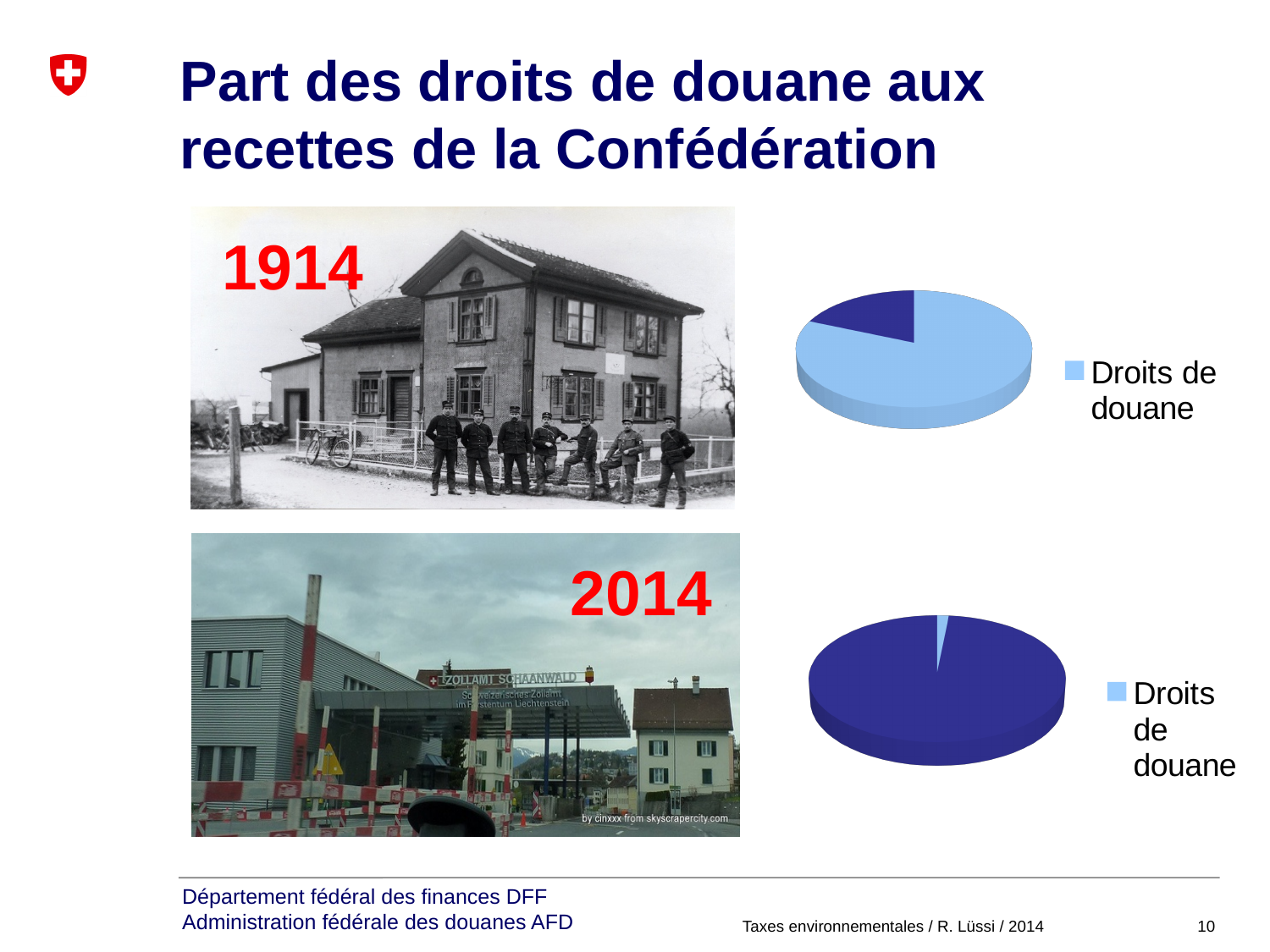
What kind of chart is shown next to the 1914 photo? Pie chart What kind of chart is shown next to the 2014 photo? Pie chart How many slices does the pie chart next to the 2014 photo have? 2 How many slices does the pie chart next to the 1914 photo have? 2 In the pie chart next to the 1914 photo, which slice is larger, the light blue one or the dark blue one? The light blue one In the pie chart next to the 2014 photo, is the light blue slice greater or less than half of the pie? less What legend entry is shown next to the pie chart for 1914? Droits de douane How many entries does the legend of the pie chart next to the 2014 photo list? 1 In the pie chart next to the 1914 photo, is the light blue slice greater or less than half of the pie? greater Which pie chart shows the larger light blue slice, the one next to the 1914 photo or the one next to the 2014 photo? The one next to the 1914 photo What is the title of the slide containing the two pie charts? Part des droits de douane aux recettes de la Confédération In the pie chart next to the 2014 photo, which slice is larger, the light blue one or the dark blue one? The dark blue one